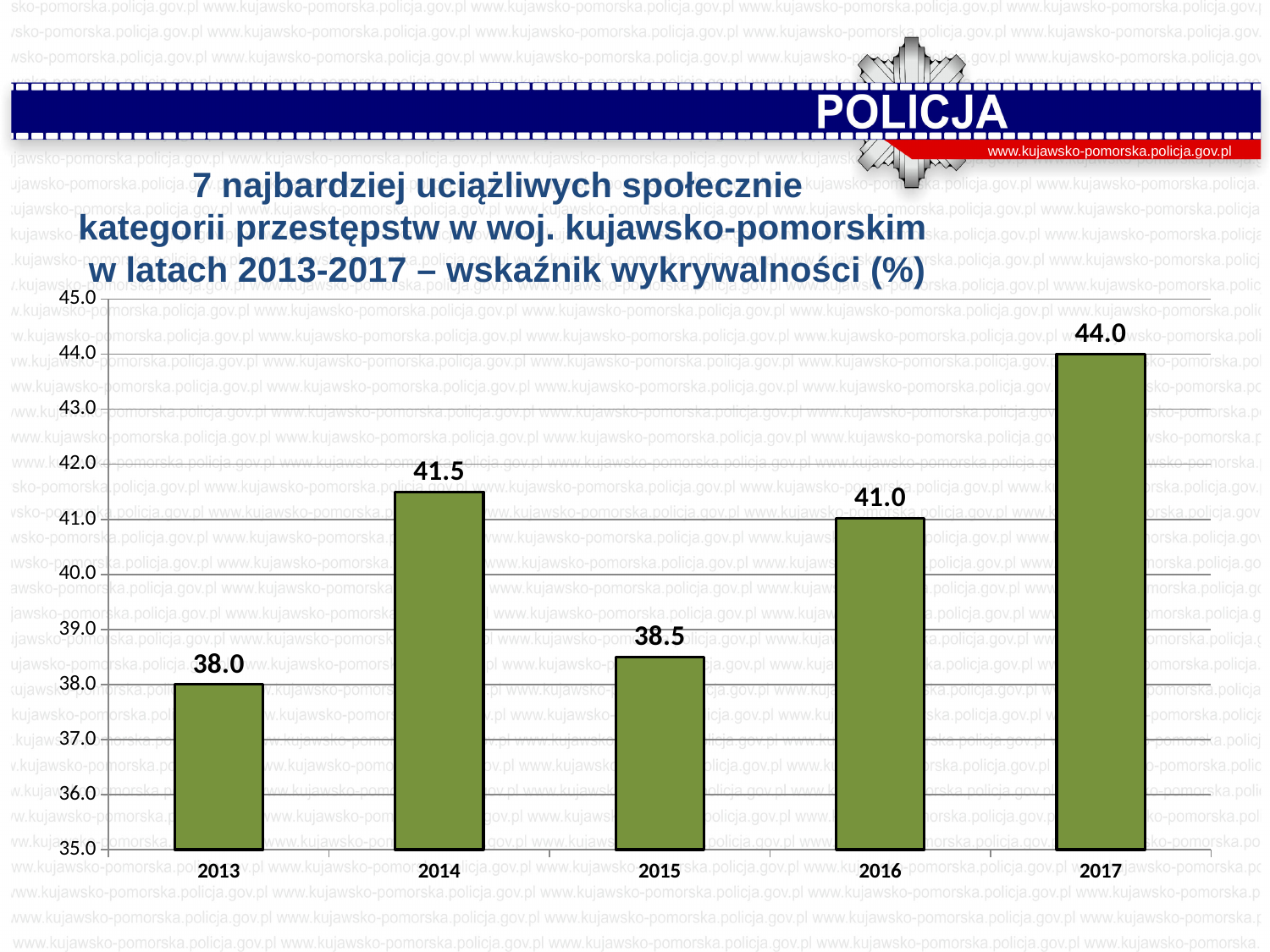
What kind of chart is shown on the slide? bar chart Is the value for 2016 greater or less than 40.0? greater What is the difference between the values for 2017 and 2013? 6.0 What is the value at the top of the y axis? 45.0 Which is larger, the value for 2014 or the value for 2015? 2014 What is the difference between the values for 2014 and 2016? 0.5 Which year has the lowest value? 2013 What is the value shown for 2015? 38.5 Which year has the highest value? 2017 What is the detection rate value for 2013? 38.0 How many years are shown on the x axis? 5 What is the value shown for 2017? 44.0